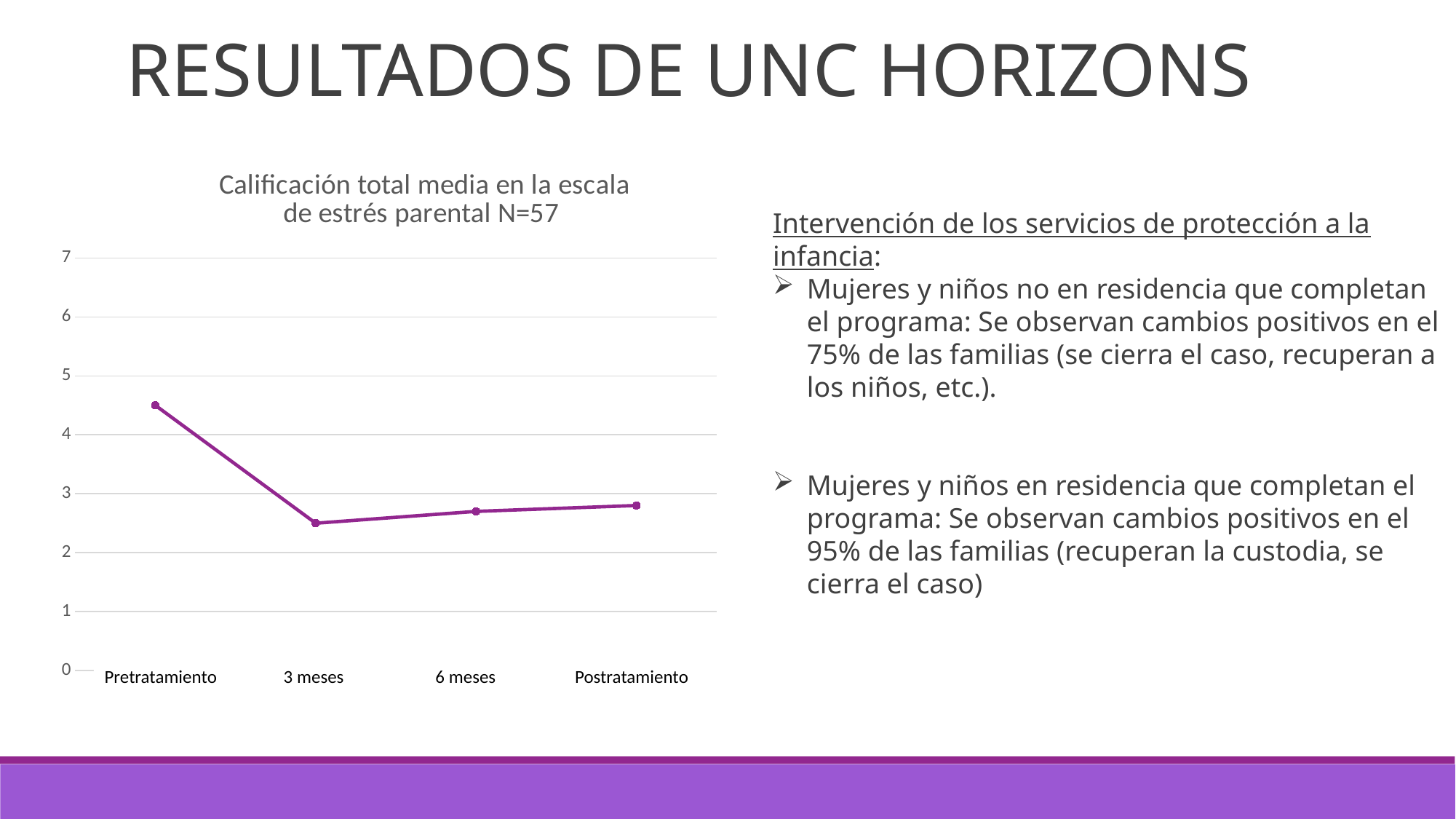
What colour is the line in the chart? purple How many time points are plotted on the x axis of the chart? 4 Is the value for 3 meses greater or less than 3? less Is the value for Pretratamiento greater or less than 4? greater What is the title of the chart? Calificación total media en la escala de estrés parental N=57 Does the value fall or rise from Pretratamiento to 3 meses? fall What kind of chart is shown on the slide? line chart Which is larger, the value for Pretratamiento or the value for Postratamiento? Pretratamiento Which time point has the highest value in the chart? Pretratamiento Is the value for 6 meses greater or less than 3? less Which time point has the lowest value in the chart? 3 meses